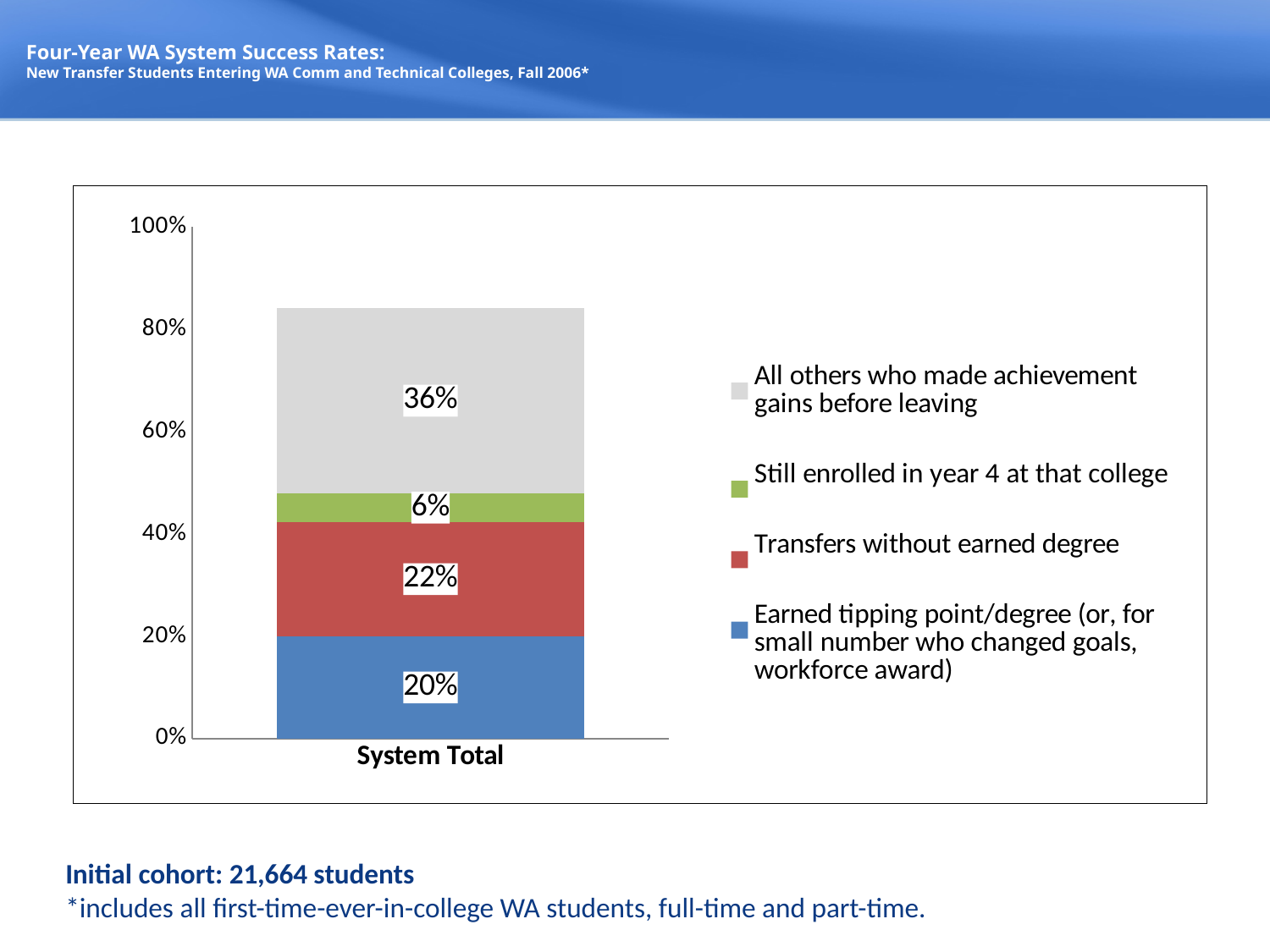
What is the value for "Earned tipping point/degree" in the System Total bar? 20% What is the value for "Still enrolled in year 4 at that college" in the System Total bar? 6% What is the total of the System Total stacked bar? 84% Which series has the smallest value in the System Total bar? Still enrolled in year 4 at that college How many series does the legend list? 4 Which series has the largest value in the System Total bar? All others who made achievement gains before leaving What is the value for "All others who made achievement gains before leaving" in the System Total bar? 36% What kind of chart is shown on the slide? stacked bar chart What is the difference between the "All others who made achievement gains before leaving" value and the "Transfers without earned degree" value? 14% What is the value for "Transfers without earned degree" in the System Total bar? 22% How many categories are plotted on the x axis? 1 Which is larger: "Transfers without earned degree" or "Earned tipping point/degree"? Transfers without earned degree